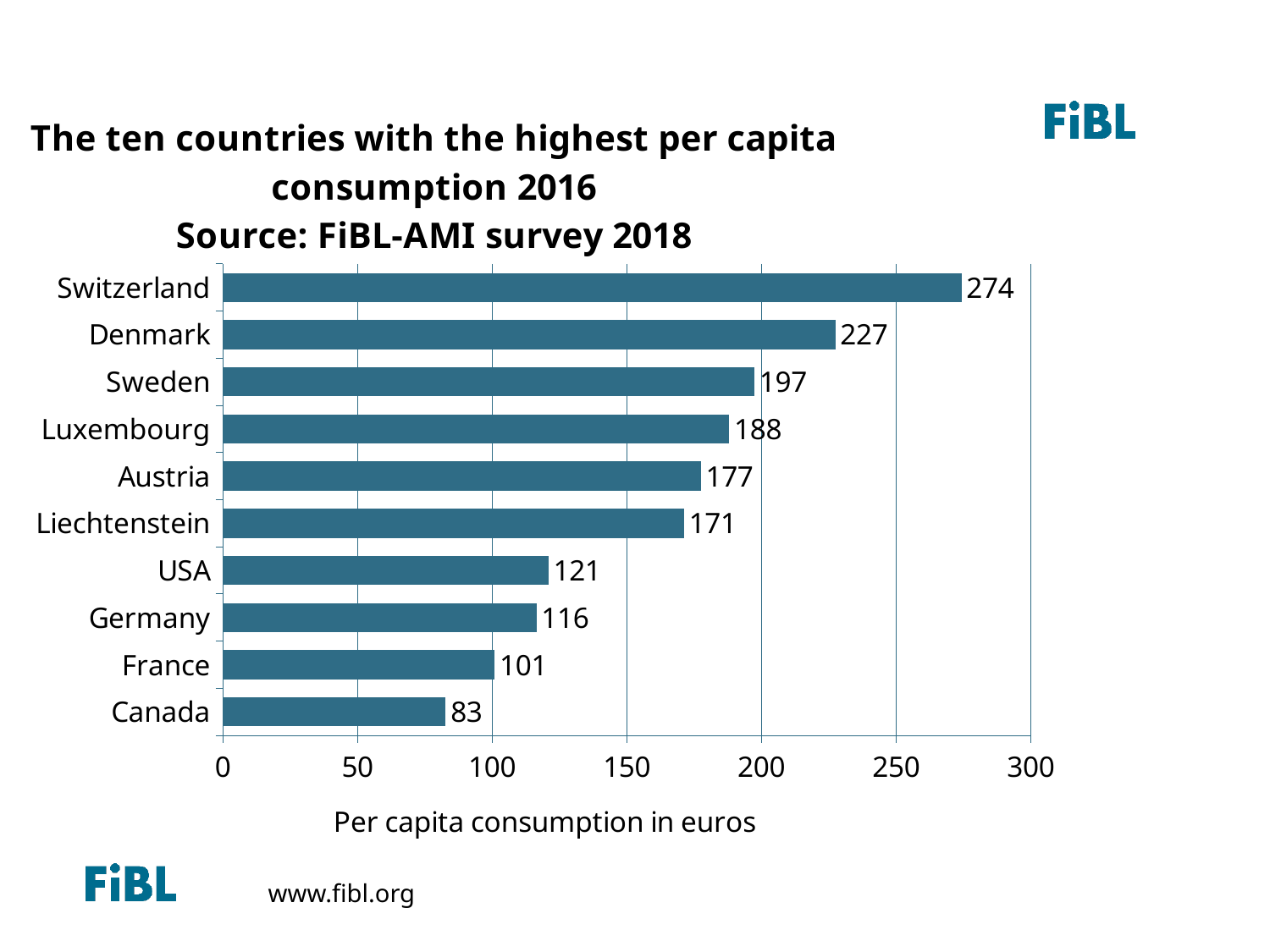
Is the value for France greater or less than 150? less What is the per capita consumption value shown for Austria? 177 Which has a higher per capita consumption, Luxembourg or Liechtenstein? Luxembourg Which country has the highest per capita consumption on the chart? Switzerland What kind of chart is shown on the slide? Bar chart Which country has the lowest per capita consumption on the chart? Canada What is the difference between the values for Denmark and Sweden? 30 What is the label of the horizontal axis? Per capita consumption in euros What is the per capita consumption value shown for Switzerland? 274 What is the difference between the values for USA and Germany? 5 How many countries are shown on the chart? 10 What is the per capita consumption value shown for Canada? 83